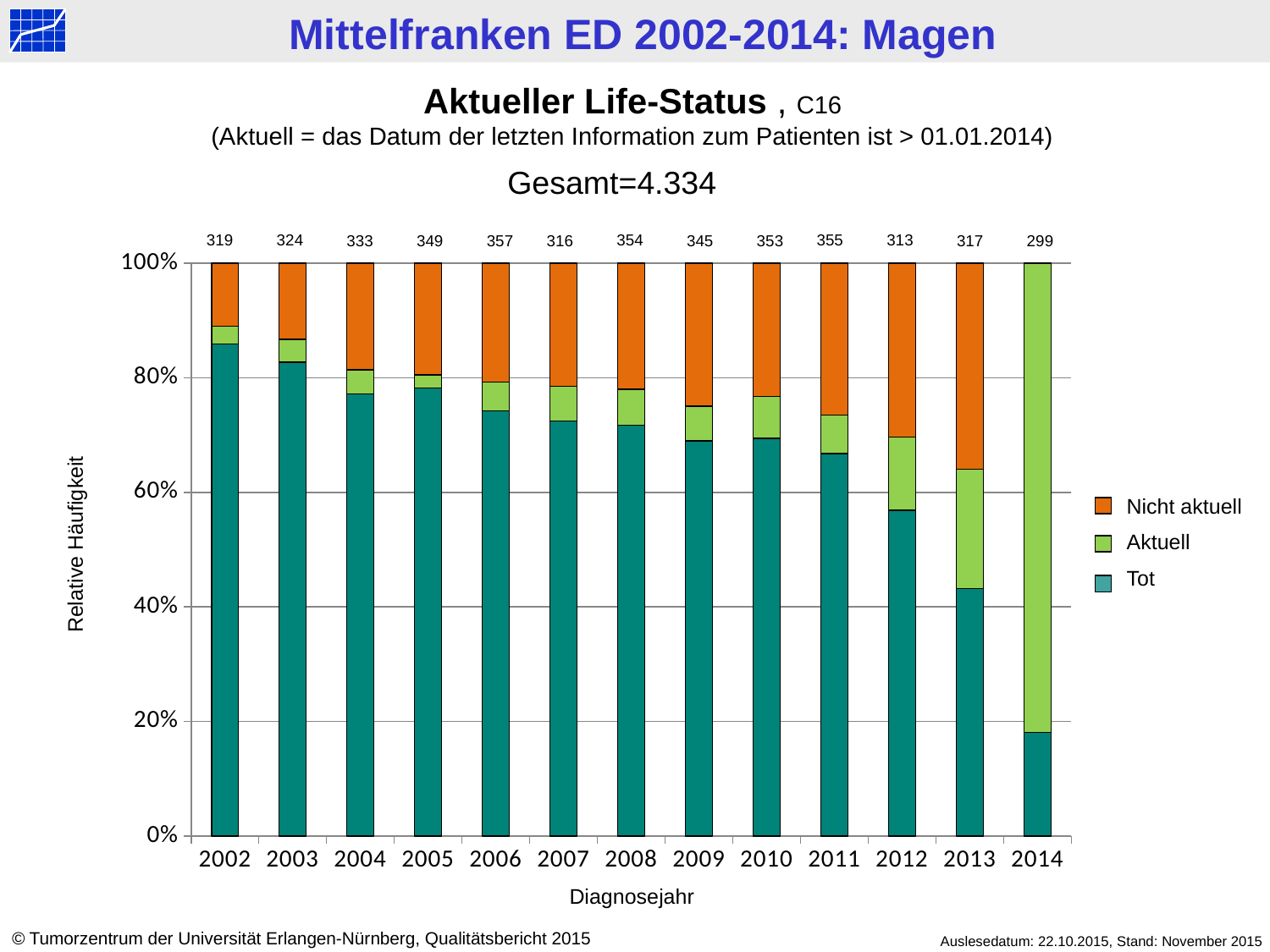
How many diagnosis years are shown on the x axis? 13 Is the 'Tot' share for 2014 greater or less than 20%? less What number is printed above the bar for 2006? 357 What number is printed above the bar for 2014? 299 Which diagnosis year has the highest number printed above its bar? 2006 How many series does the legend list? 3 Which diagnosis year has the lowest number printed above its bar? 2014 Is the 'Tot' share for 2002 greater or less than 80%? greater What number is printed above the bar for 2002? 319 What is the difference between the numbers printed above the bars for 2006 and 2014? 58 Does the 'Tot' share rise or fall from 2002 to 2014? fall Which year has the larger number printed above its bar, 2011 or 2012? 2011